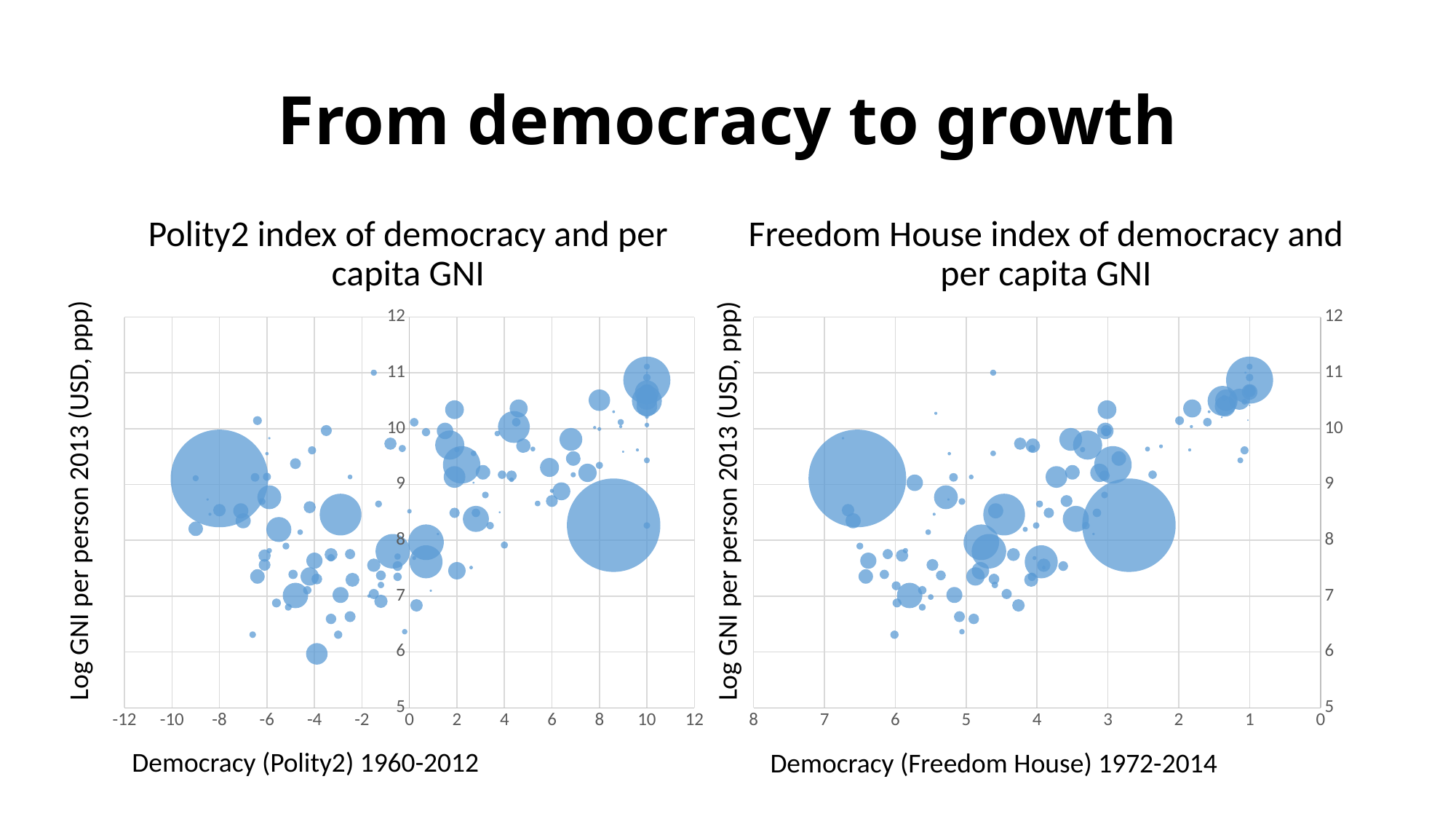
How many charts are shown on the slide? 2 What is the highest value shown on the y axis of the 'Polity2 index of democracy and per capita GNI' chart? 12 What is the y-axis label of the 'Polity2 index of democracy and per capita GNI' chart? Log GNI per person 2013 (USD, ppp) What is the x-axis label of the 'Freedom House index of democracy and per capita GNI' chart? Democracy (Freedom House) 1972-2014 In the 'Freedom House index of democracy and per capita GNI' chart, do the log GNI values generally rise or fall as you move from left to right along the x axis? rise What kind of chart is the 'Polity2 index of democracy and per capita GNI' chart? bubble chart What kind of chart is the 'Freedom House index of democracy and per capita GNI' chart? bubble chart In the 'Polity2 index of democracy and per capita GNI' chart, do the log GNI values generally rise or fall as you move from left to right along the x axis? rise